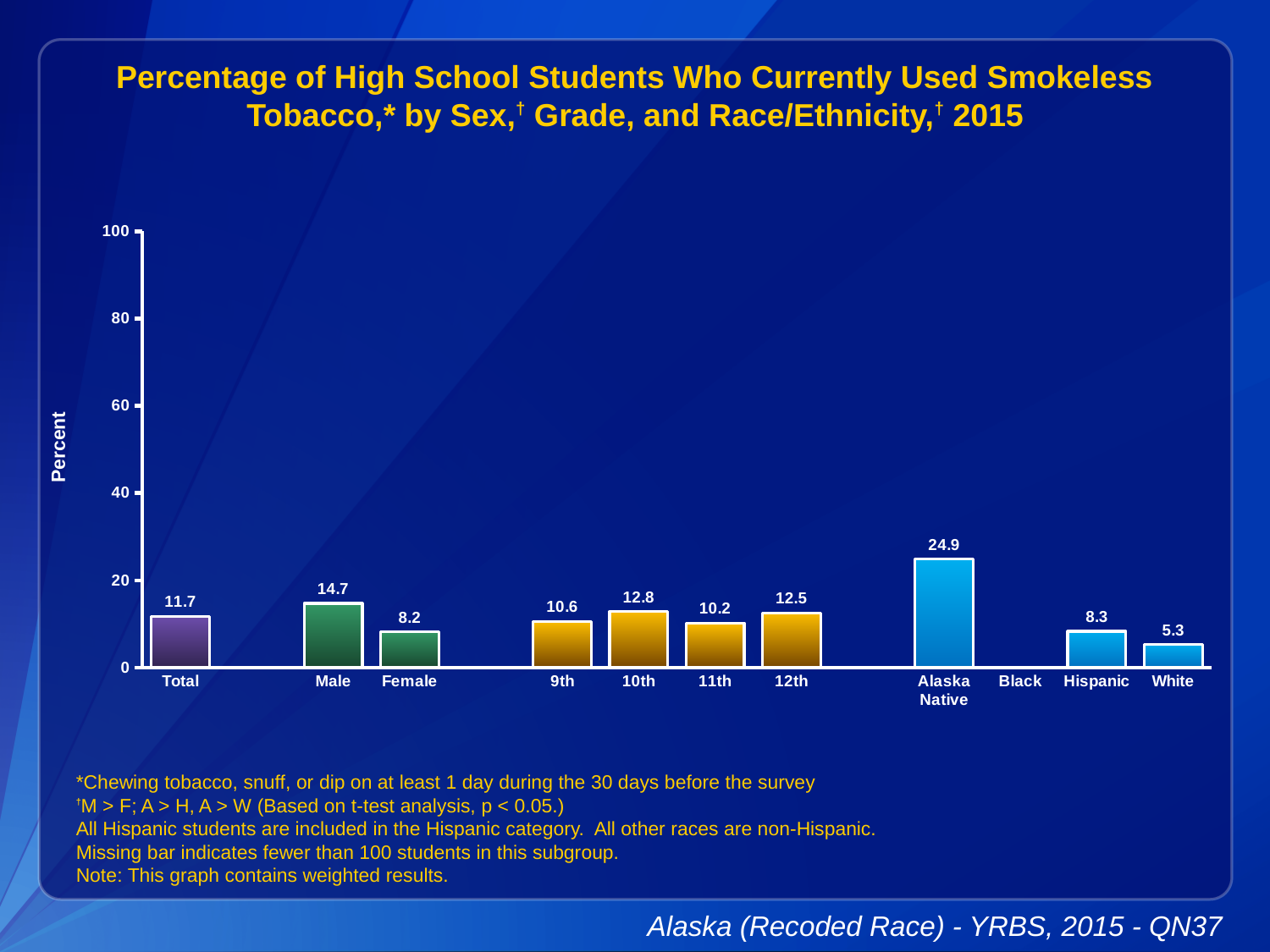
Which is larger, the value for 9th grade or the value for 12th grade? 12th What is the difference between the Male and Female values? 6.5 Is the value for Alaska Native greater or less than 20? greater What is the label on the y axis? Percent How many bars are plotted on the chart? 11 What kind of chart is shown? bar chart What is the value for 10th grade? 12.8 Which category has no bar plotted? Black Which category with a plotted bar has the lowest value? White What is the value for Total? 11.7 What is the value for Alaska Native? 24.9 Which category has the highest value? Alaska Native